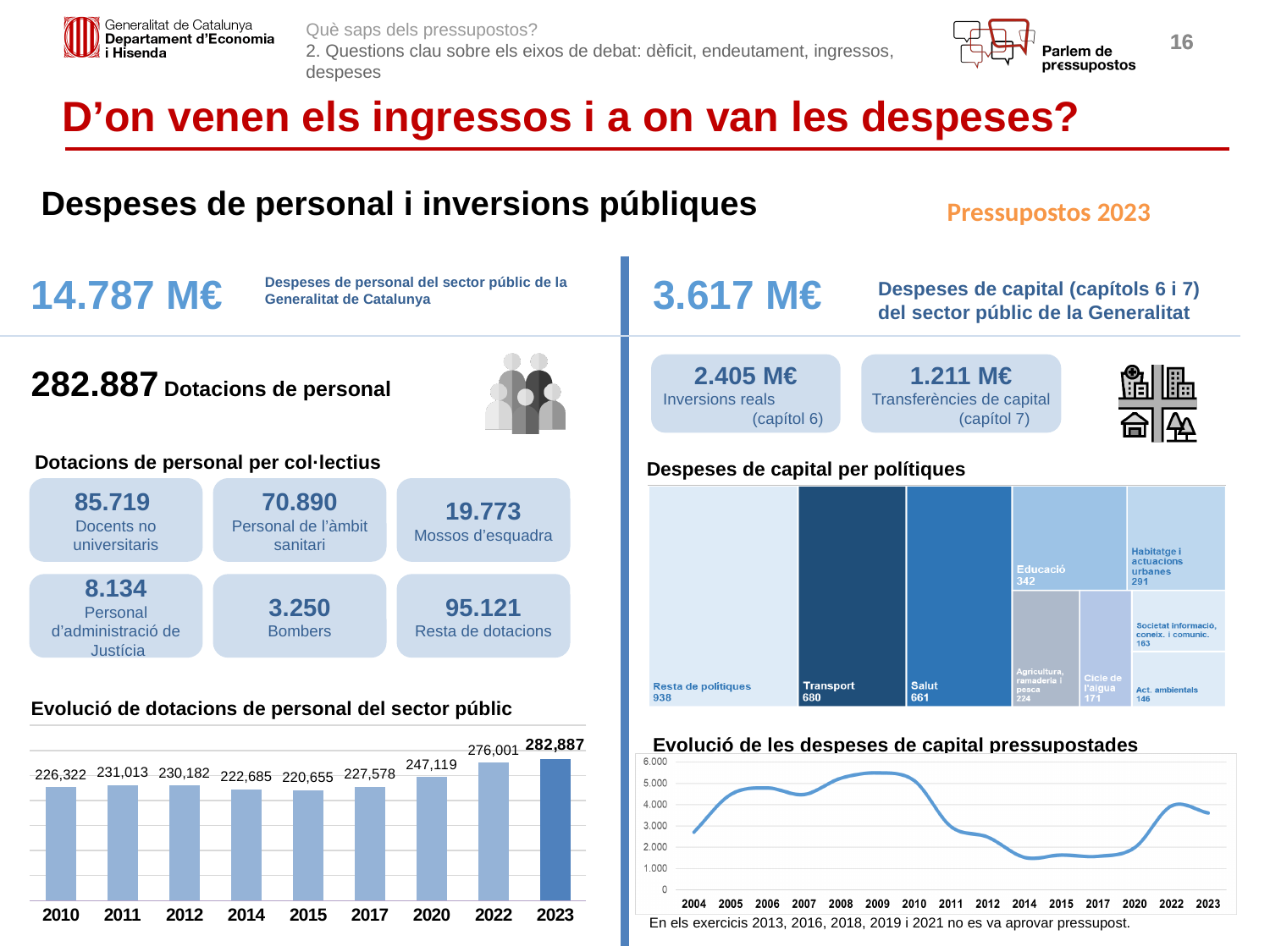
In the 'Evolució de dotacions de personal del sector públic' chart, what is the value for 2023? 282,887 In the 'Despeses de capital per polítiques' chart, what is the difference between Educació and Act. ambientals? 196 In the 'Despeses de capital per polítiques' chart, what is the value for Transport? 680 In the 'Evolució de les despeses de capital pressupostades' chart, is the value for 2009 greater or less than 5,000? greater In the 'Evolució de dotacions de personal del sector públic' chart, which year has the lowest value? 2015 In the 'Evolució de dotacions de personal del sector públic' chart, how many years are shown? 9 What kind of chart is 'Evolució de les despeses de capital pressupostades'? Line chart In the 'Evolució de dotacions de personal del sector públic' chart, what is the difference between the 2023 and 2022 values? 6,886 What kind of chart is 'Evolució de dotacions de personal del sector públic'? Bar chart In the 'Evolució de dotacions de personal del sector públic' chart, what is the value for 2015? 220,655 In the 'Despeses de capital per polítiques' chart, which is larger, Salut or Educació? Salut In the 'Evolució de les despeses de capital pressupostades' chart, is the value for 2014 greater or less than 2,000? less